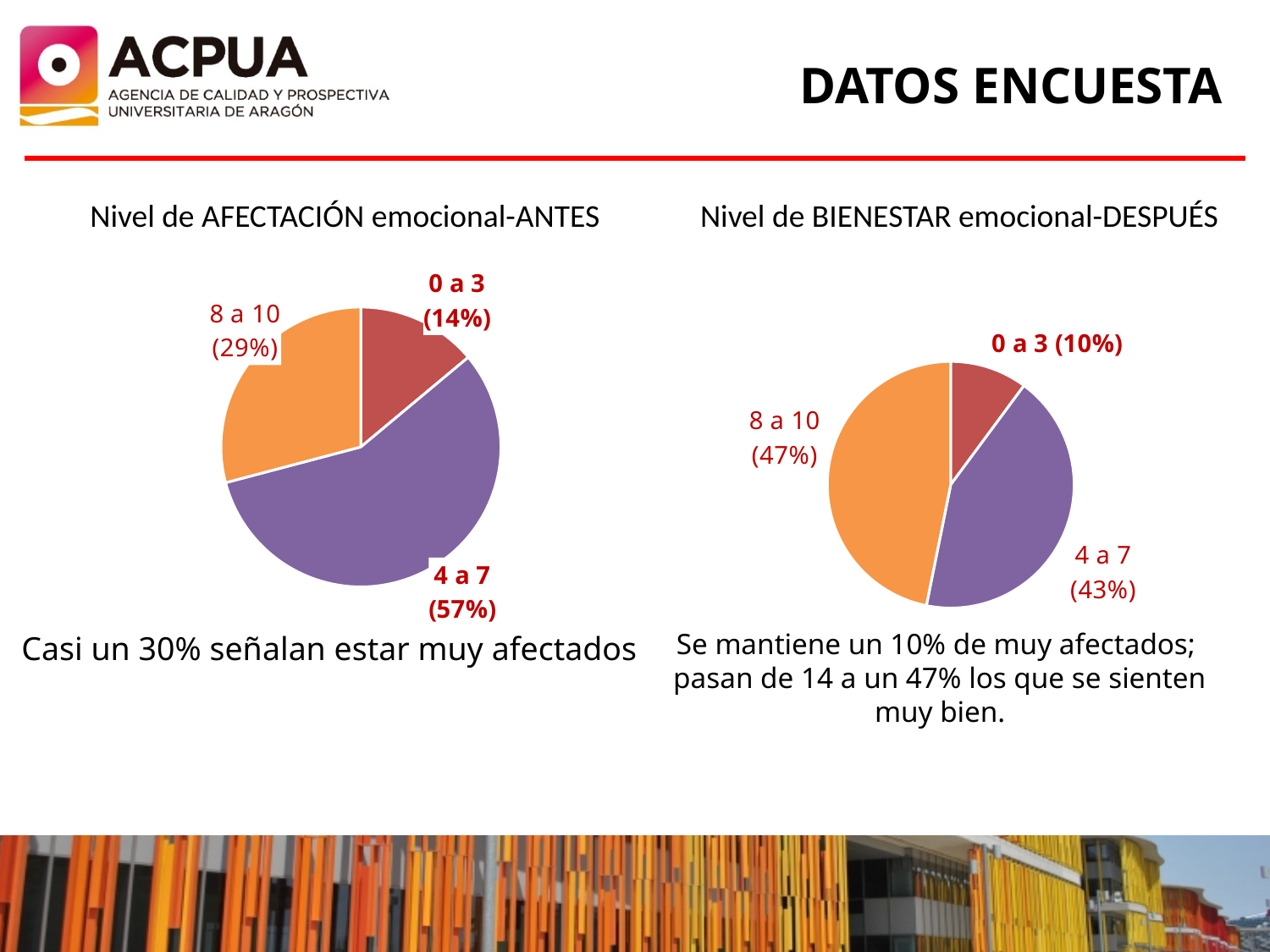
In the 'Nivel de BIENESTAR emocional-DESPUÉS' chart, what share does the '8 a 10' slice have? 47% In the 'Nivel de AFECTACIÓN emocional-ANTES' chart, what share does the '0 a 3' slice have? 14% In the 'Nivel de BIENESTAR emocional-DESPUÉS' chart, which category has the smallest slice? 0 a 3 In the 'Nivel de AFECTACIÓN emocional-ANTES' chart, which category has the largest slice? 4 a 7 In the 'Nivel de BIENESTAR emocional-DESPUÉS' chart, which category has the largest slice? 8 a 10 What is the difference between the '8 a 10' share in the 'Nivel de BIENESTAR emocional-DESPUÉS' chart and the '8 a 10' share in the 'Nivel de AFECTACIÓN emocional-ANTES' chart? 18% How many slices does the 'Nivel de AFECTACIÓN emocional-ANTES' chart have? 3 In the 'Nivel de AFECTACIÓN emocional-ANTES' chart, what share does the '8 a 10' slice have? 29% What kind of chart is the 'Nivel de BIENESTAR emocional-DESPUÉS' chart? Pie chart